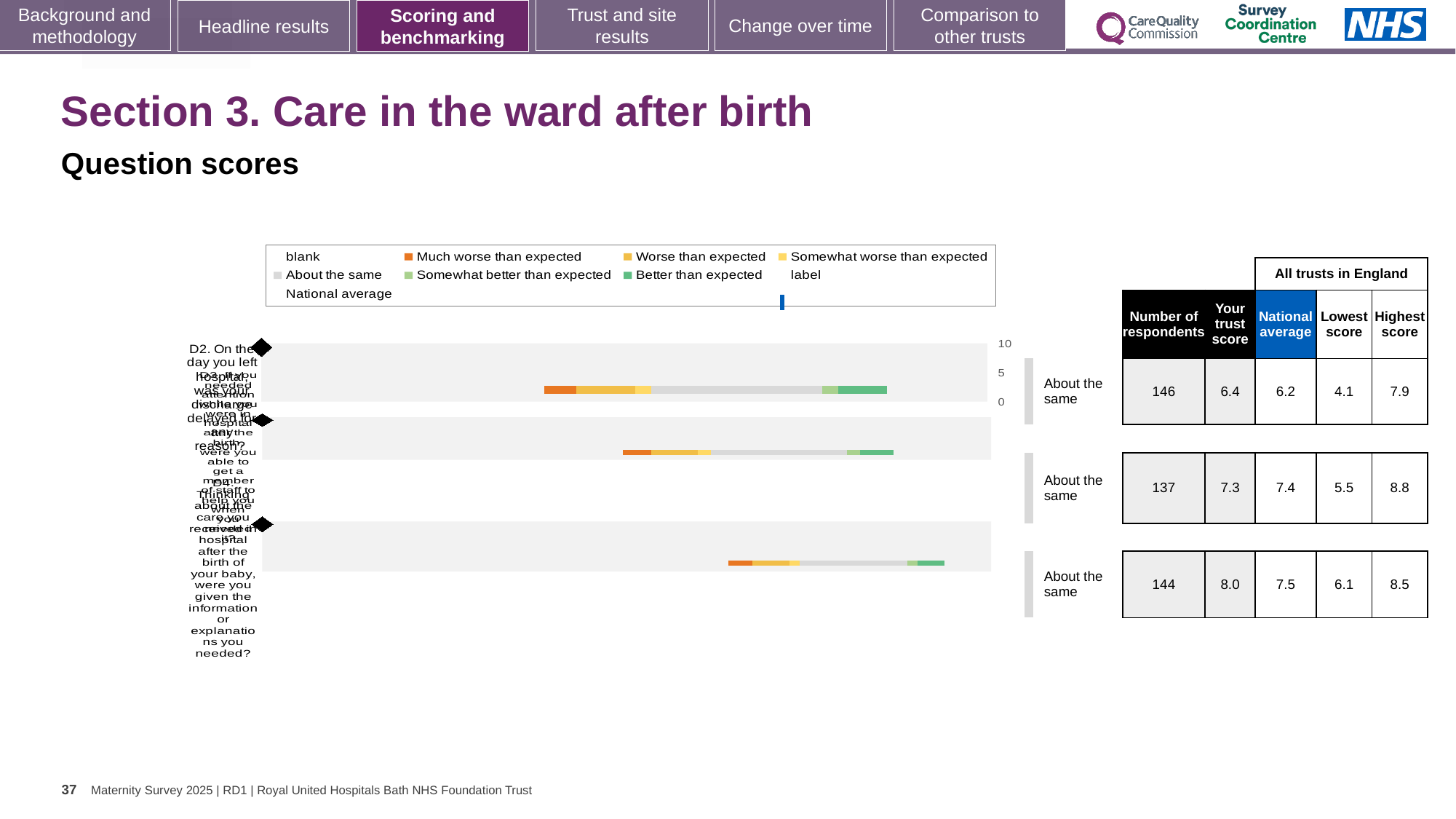
In the table beside the chart, what is the difference between the highest score and lowest score for the top row? 3.8 What benchmark label is shown next to each of the three rows? About the same In the table beside the chart, what is the trust score for the bottom row? 8.0 In the table beside the chart, which row has the highest trust score: top, middle or bottom? bottom What kind of chart is shown on the slide? bar chart In the table beside the chart, what is the national average for the middle row? 7.4 In the table beside the chart, what is the number of respondents for the top row? 146 Which legend entry is shown with a dark orange colour? Much worse than expected How many bars are plotted in the chart? 3 What is the highest value shown on the chart's numeric axis? 10 In the table beside the chart, is the trust score for the middle row larger or smaller than its national average? smaller